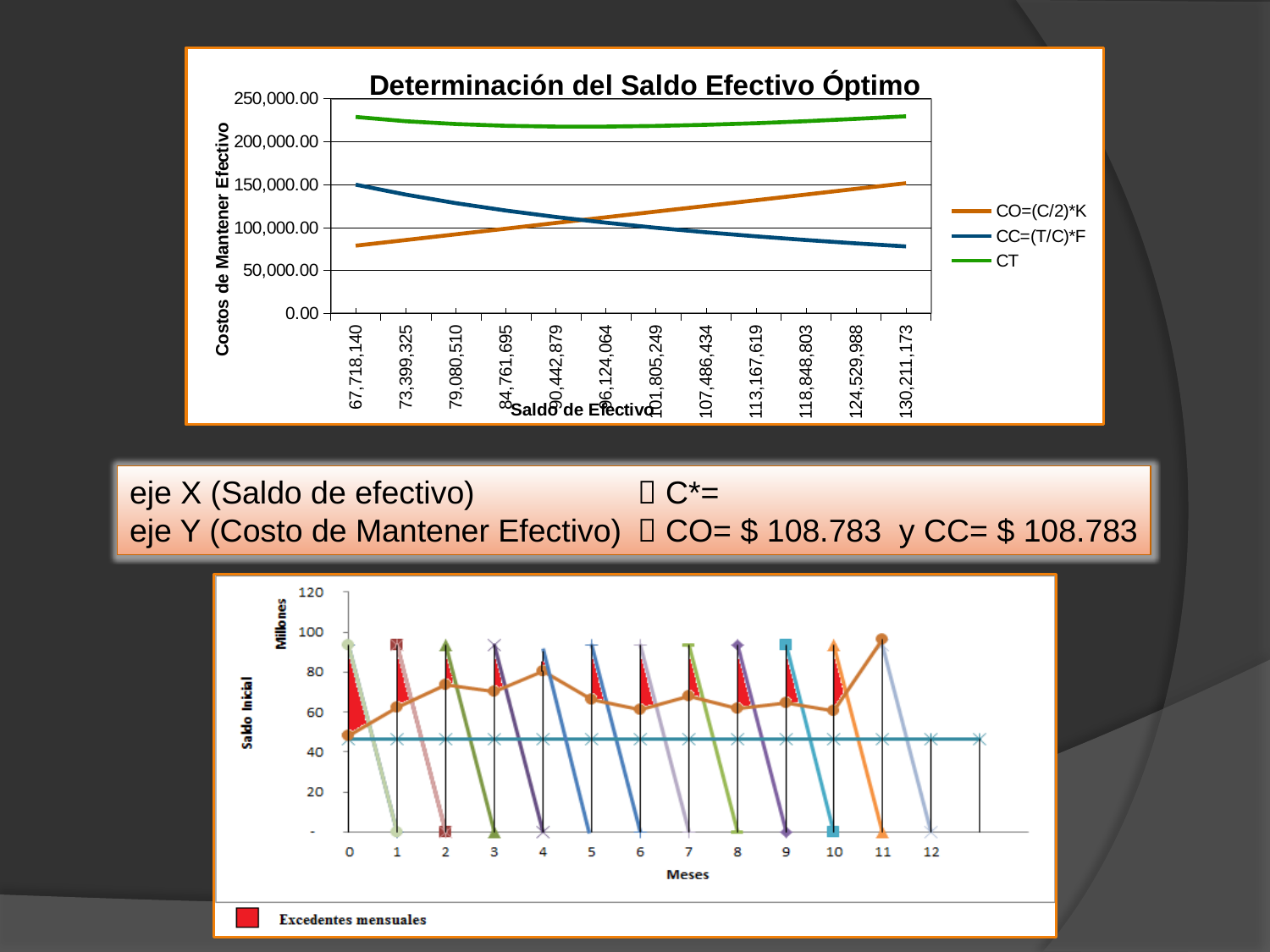
In the top chart titled 'Determinación del Saldo Efectivo Óptimo', what kind of chart is shown? line chart In the top chart 'Determinación del Saldo Efectivo Óptimo', is the value of CO=(C/2)*K at 67,718,140 greater or less than 100,000.00? less In the top chart 'Determinación del Saldo Efectivo Óptimo', is the value of CT at 67,718,140 greater or less than 200,000.00? greater In the top chart 'Determinación del Saldo Efectivo Óptimo', is the value of CC=(T/C)*F at 130,211,173 greater or less than 100,000.00? less In the top chart 'Determinación del Saldo Efectivo Óptimo', does the CC=(T/C)*F series rise or fall as Saldo de Efectivo increases? fall In the top chart 'Determinación del Saldo Efectivo Óptimo', how many series does the legend list? 3 In the top chart 'Determinación del Saldo Efectivo Óptimo', at 67,718,140 which series has the larger value, CO=(C/2)*K or CC=(T/C)*F? CC=(T/C)*F In the top chart 'Determinación del Saldo Efectivo Óptimo', how many categories are shown on the x axis? 12 In the top chart 'Determinación del Saldo Efectivo Óptimo', does the CO=(C/2)*K series rise or fall as Saldo de Efectivo increases? rise In the top chart 'Determinación del Saldo Efectivo Óptimo', which series has the highest values across the whole x axis? CT In the top chart 'Determinación del Saldo Efectivo Óptimo', what is the label of the y axis? Costos de Mantener Efectivo In the bottom chart, what is the label of the x axis? Meses